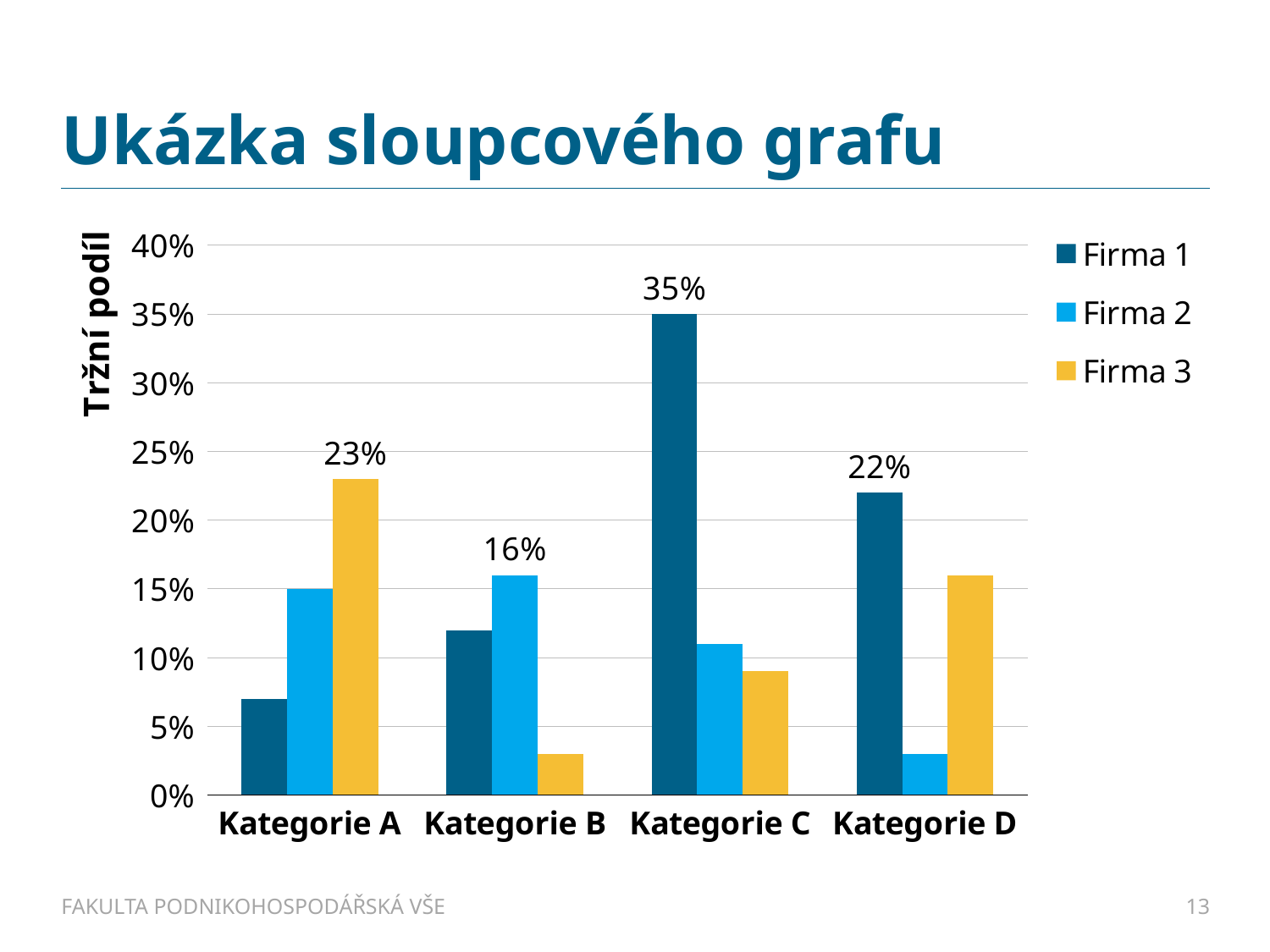
Is the value for Firma 2 in Kategorie D greater or less than 5%? less What is the value for Firma 2 in Kategorie B? 16% What is the value for Firma 1 in Kategorie D? 22% What is the value for Firma 3 in Kategorie A? 23% What is the value for Firma 1 in Kategorie C? 35% What is the difference between the Firma 1 values in Kategorie C and Kategorie D? 13% Which series has the highest value in Kategorie A? Firma 3 How many series does the legend list? 3 Is the value for Firma 1 in Kategorie A greater or less than 10%? less How many categories are shown on the x axis? 4 Which category has the highest bar in the chart? Kategorie C Which is larger: Firma 3 in Kategorie A or Firma 2 in Kategorie B? Firma 3 in Kategorie A